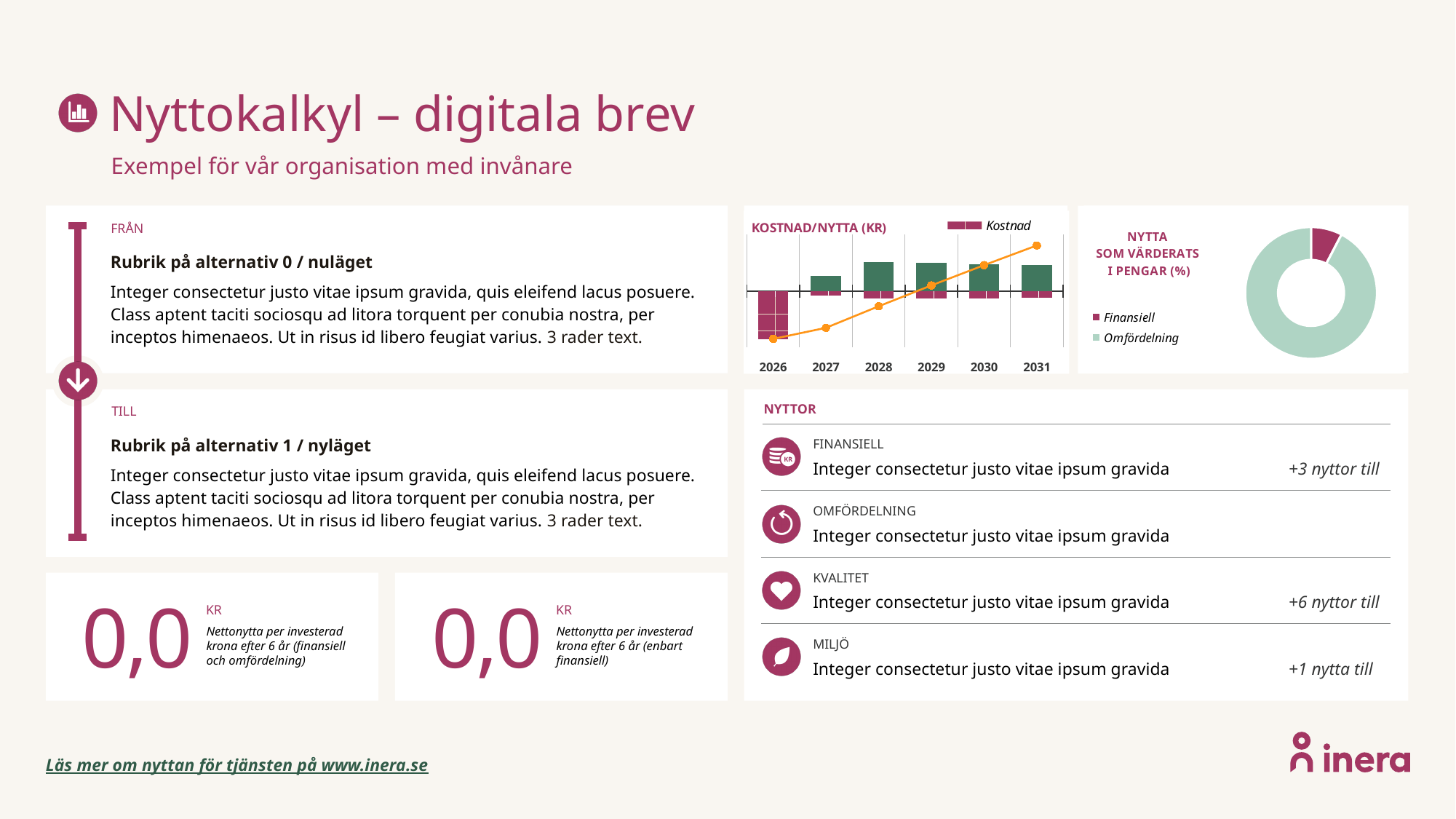
What series name is shown in the legend of the KOSTNAD/NYTTA (KR) chart? Kostnad In the KOSTNAD/NYTTA (KR) chart, what is the last year on the x axis? 2031 In the KOSTNAD/NYTTA (KR) chart, does the orange line rise or fall from 2026 to 2031? rises In the KOSTNAD/NYTTA (KR) chart, which year has a larger green bar, 2027 or 2028? 2028 In the NYTTA SOM VÄRDERATS I PENGAR (%) chart, which category has the smallest slice? Finansiell In the KOSTNAD/NYTTA (KR) chart, in which year is the magenta Kostnad bar the largest? 2026 In the NYTTA SOM VÄRDERATS I PENGAR (%) chart, which slice is larger, Finansiell or Omfördelning? Omfördelning What kind of chart is the NYTTA SOM VÄRDERATS I PENGAR (%) chart? donut chart How many entries does the legend of the NYTTA SOM VÄRDERATS I PENGAR (%) chart list? 2 In the KOSTNAD/NYTTA (KR) chart, what is the first year on the x axis? 2026 In the KOSTNAD/NYTTA (KR) chart, which year has a larger magenta bar, 2026 or 2031? 2026 In the KOSTNAD/NYTTA (KR) chart, how many years are shown on the x axis? 6